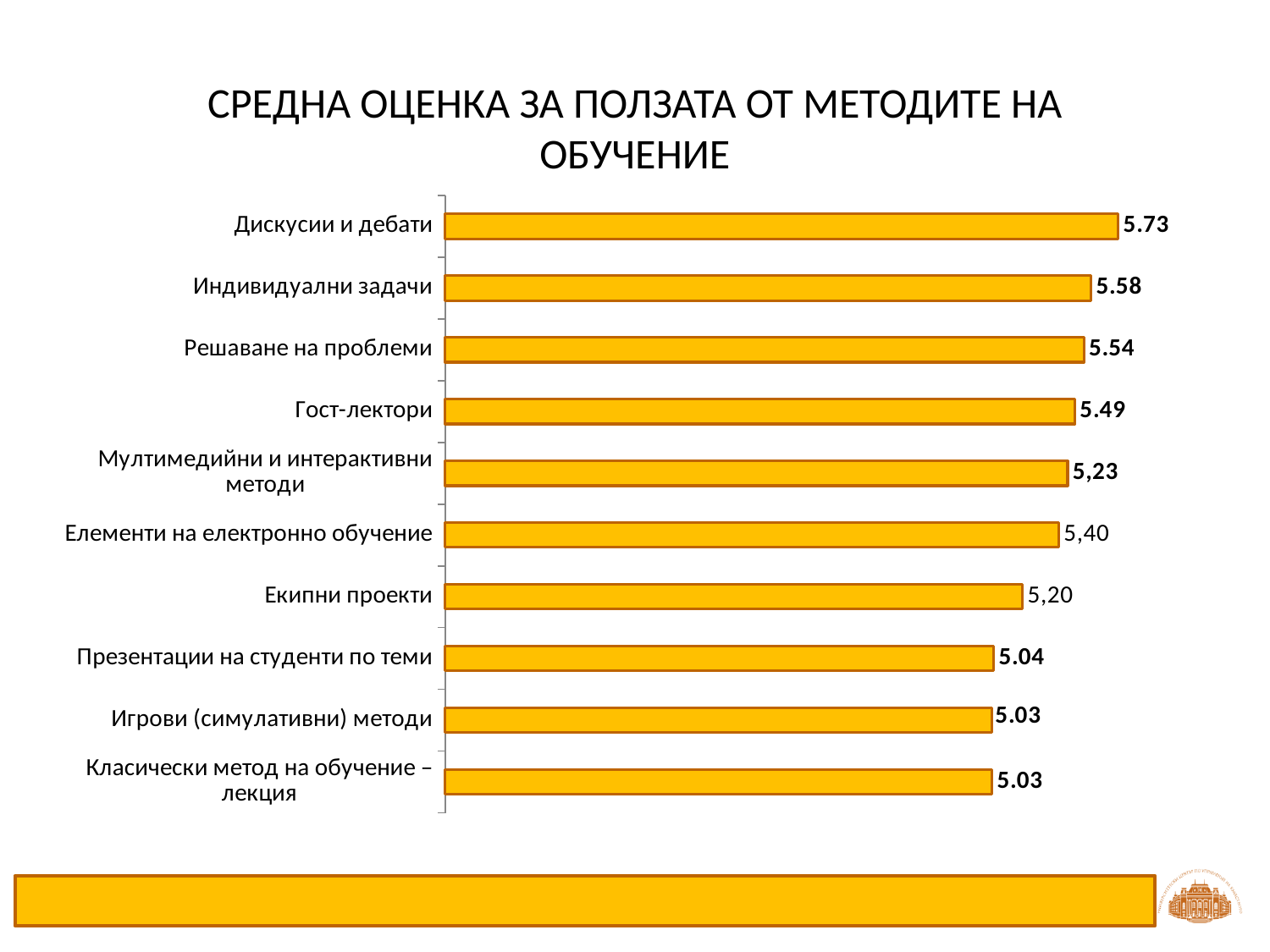
What is the value for Екипни проекти? 5,20 What colour are the bars in the chart? Orange What is the difference between the values for Дискусии и дебати and Индивидуални задачи? 0.15 What is the value for Гост-лектори? 5.49 What is the value for Дискусии и дебати? 5.73 What is the value for Елементи на електронно обучение? 5,40 What kind of chart is shown on the slide? Bar chart Which category has the highest value? Дискусии и дебати Which is larger, the value for Решаване на проблеми or the value for Презентации на студенти по теми? Решаване на проблеми How many categories are shown in the chart? 10 What is the title of the chart? СРЕДНА ОЦЕНКА ЗА ПОЛЗАТА ОТ МЕТОДИТЕ НА ОБУЧЕНИЕ What is the difference between the values for Мултимедийни и интерактивни методи and Игрови (симулативни) методи? 0.20